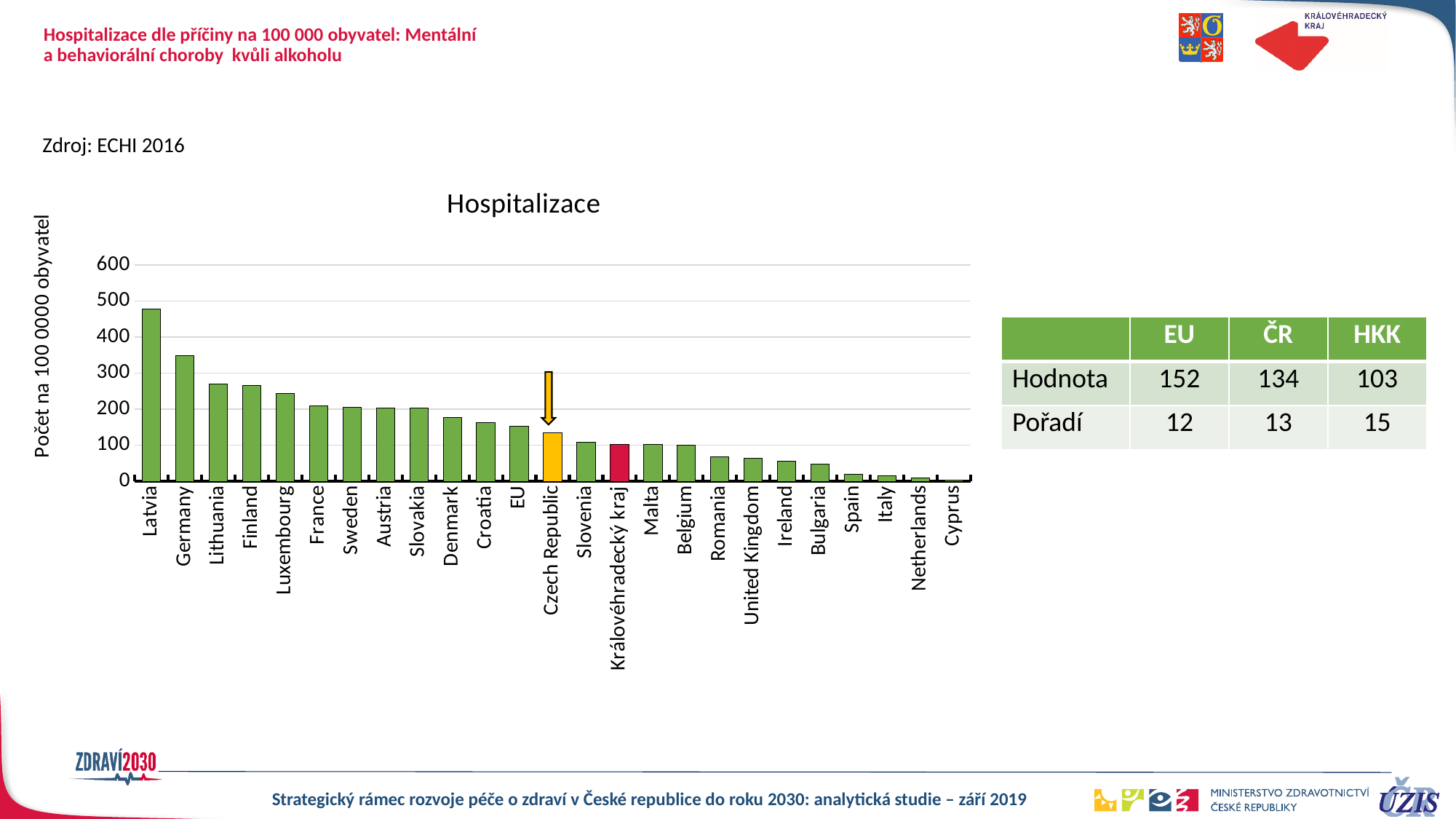
Which category has the lowest hospitalization value in the chart? Cyprus What is the hospitalization value for Královéhradecký kraj (HKK)? 103 What is the difference between the EU value and the ČR value? 18 What is the hospitalization value for the EU? 152 Is the value for Denmark greater or less than 200? less Which has a larger value, Germany or Finland? Germany What kind of chart is shown on the slide? bar chart How many categories (bars) are plotted in the chart? 25 What is the hospitalization value for the Czech Republic (ČR)? 134 Is the value for Latvia greater or less than 400? greater Which category has the highest hospitalization value in the chart? Latvia Do the values rise or fall from left to right along the x axis? fall